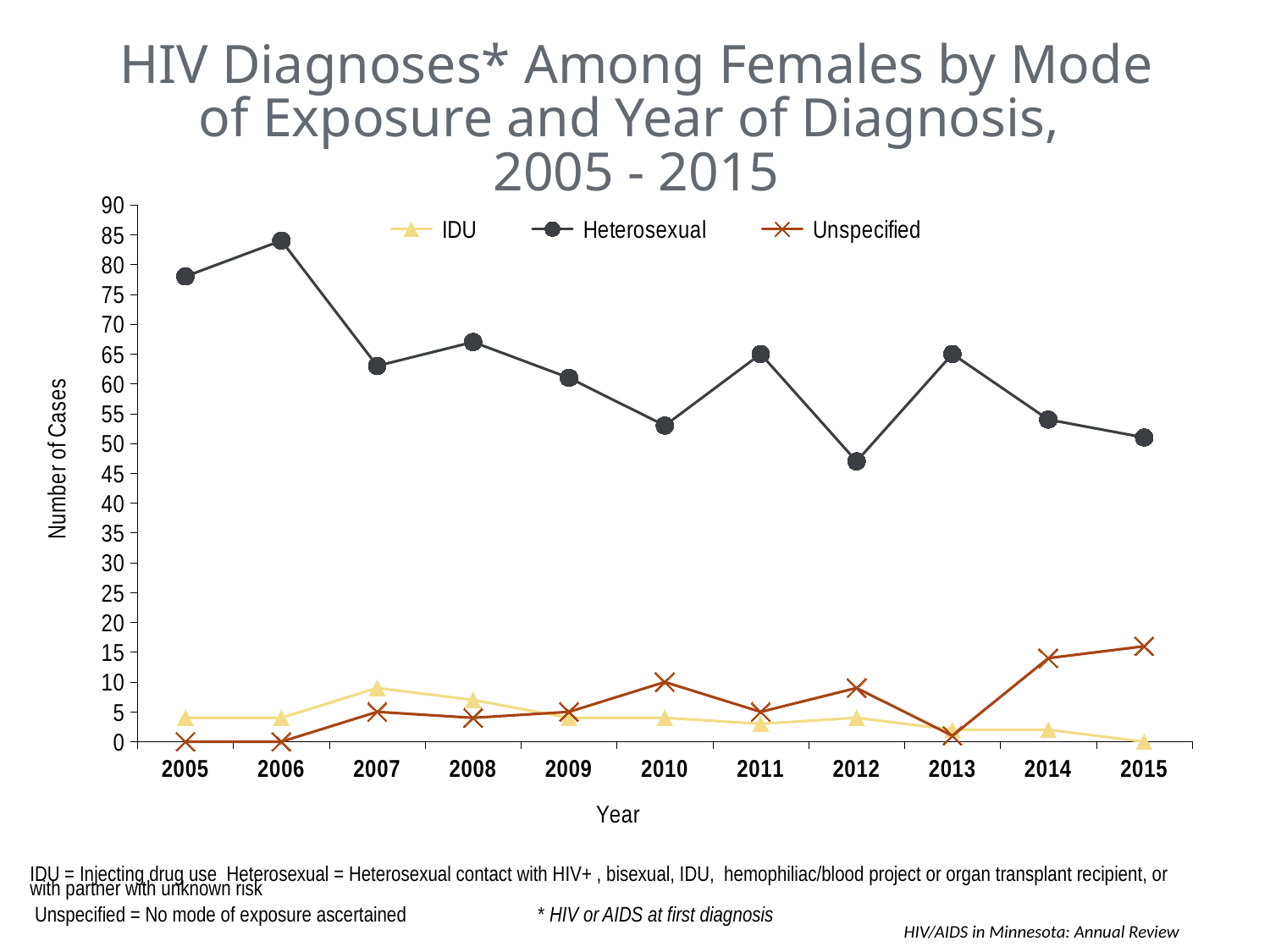
How many series does the legend list? 3 Is the Heterosexual value for 2005 greater or less than 75? greater How many years are plotted along the x axis? 11 In which year is the Unspecified series at its highest? 2015 In 2015, which is larger: the Unspecified value or the IDU value? Unspecified In which year is the Heterosexual series at its highest? 2006 In which year is the Heterosexual series at its lowest? 2012 Is the Heterosexual value for 2012 greater or less than 50? less What kind of chart is shown on the slide? Line chart What is the label on the x axis? Year What is the Unspecified value for 2005? 0 Does the Heterosexual series overall rise or fall from 2005 to 2015? Fall